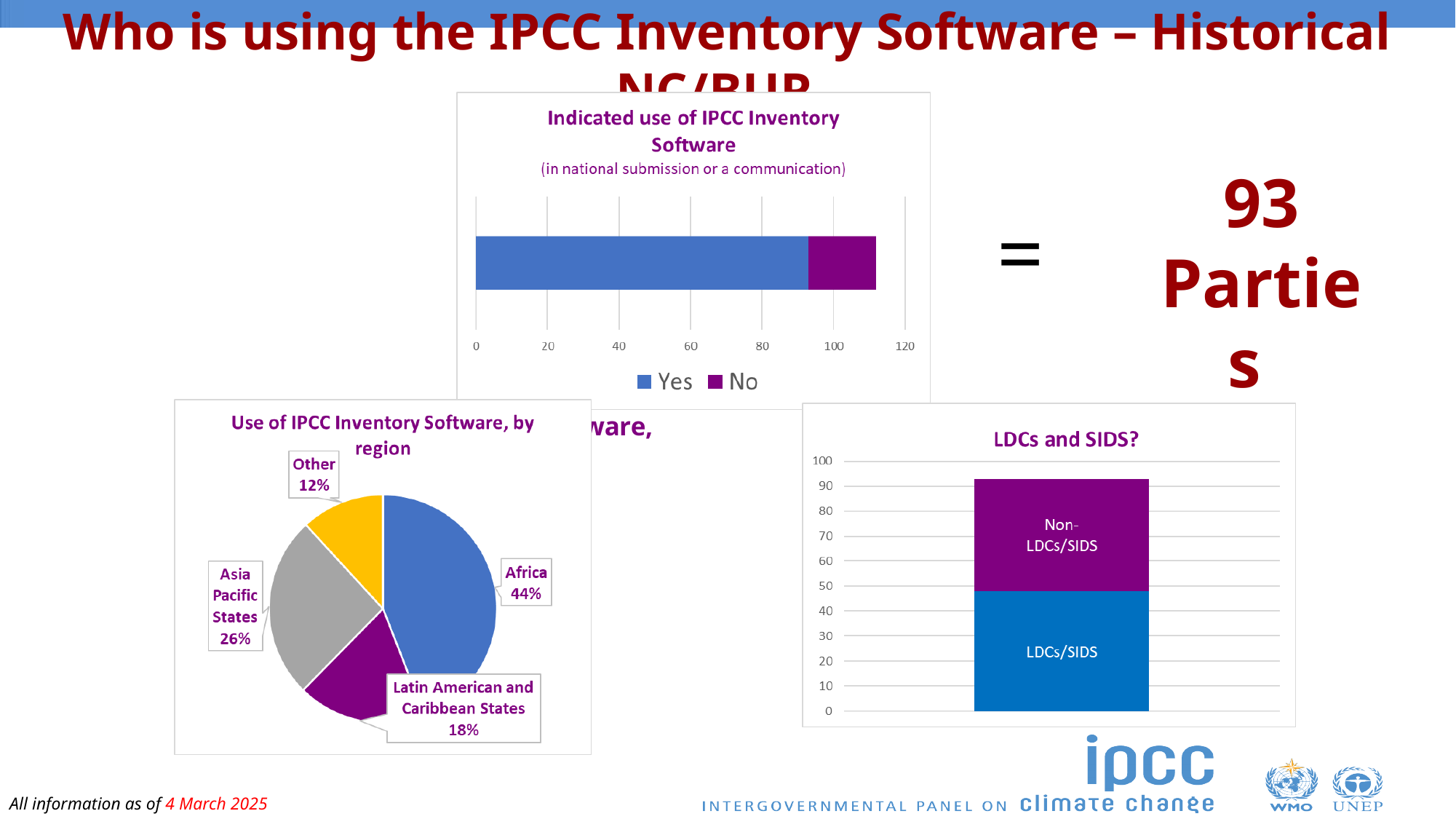
In the pie chart 'Use of IPCC Inventory Software, by region', how many percentage points larger is Africa's share than that of Asia Pacific States? 18 In the pie chart 'Use of IPCC Inventory Software, by region', what share do Asia Pacific States have? 26% How many slices does the pie chart 'Use of IPCC Inventory Software, by region' have? 4 In the chart 'Indicated use of IPCC Inventory Software', is the value for 'Yes' greater or less than 80? greater In the pie chart 'Use of IPCC Inventory Software, by region', which region has the largest share? Africa How many series does the legend of the chart 'Indicated use of IPCC Inventory Software' list? 2 In the pie chart 'Use of IPCC Inventory Software, by region', which is larger: the share of Asia Pacific States or of Latin American and Caribbean States? Asia Pacific States In the pie chart 'Use of IPCC Inventory Software, by region', what share does Africa have? 44% What kind of chart is 'Indicated use of IPCC Inventory Software'? Bar chart In the pie chart 'Use of IPCC Inventory Software, by region', which category has the smallest share? Other In the chart 'LDCs and SIDS?', is the total height of the stacked bar greater or less than 80? greater In the pie chart 'Use of IPCC Inventory Software, by region', what share do Latin American and Caribbean States have? 18%